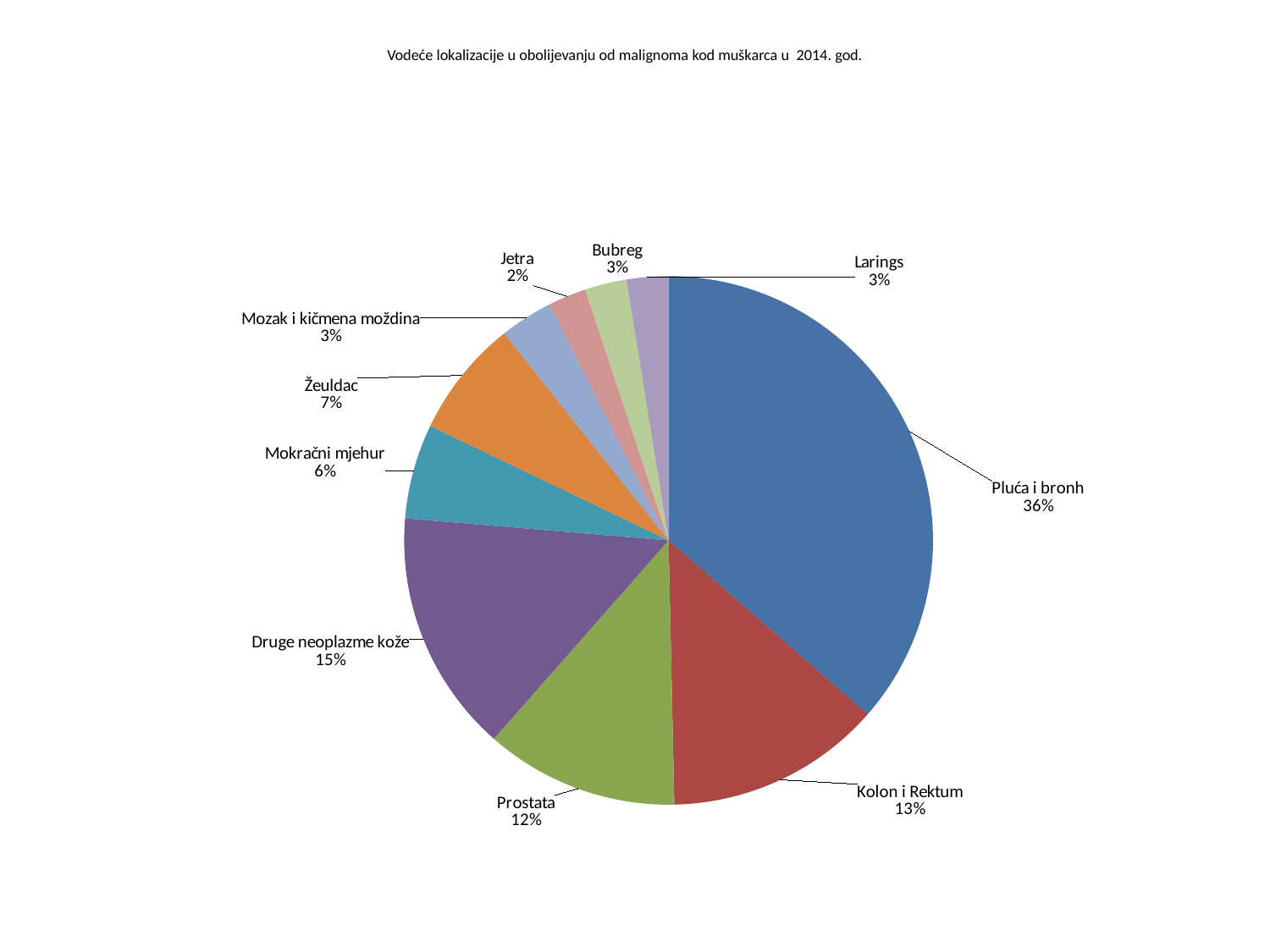
What kind of chart is shown on the slide? pie chart Which category has the largest slice of the pie? Pluća i bronh What share of the pie does Prostata have? 12% What share of the pie does Druge neoplazme kože have? 15% What is the title of the chart? Vodeće lokalizacije u obolijevanju od malignoma kod muškarca u 2014. god. What is the difference between the shares of Pluća i bronh and Kolon i Rektum? 23% Which category has the smallest slice of the pie? Jetra How many categories are shown in the pie chart? 10 What share of the pie does Pluća i bronh have? 36% Which is larger, the share for Druge neoplazme kože or the share for Prostata? Druge neoplazme kože